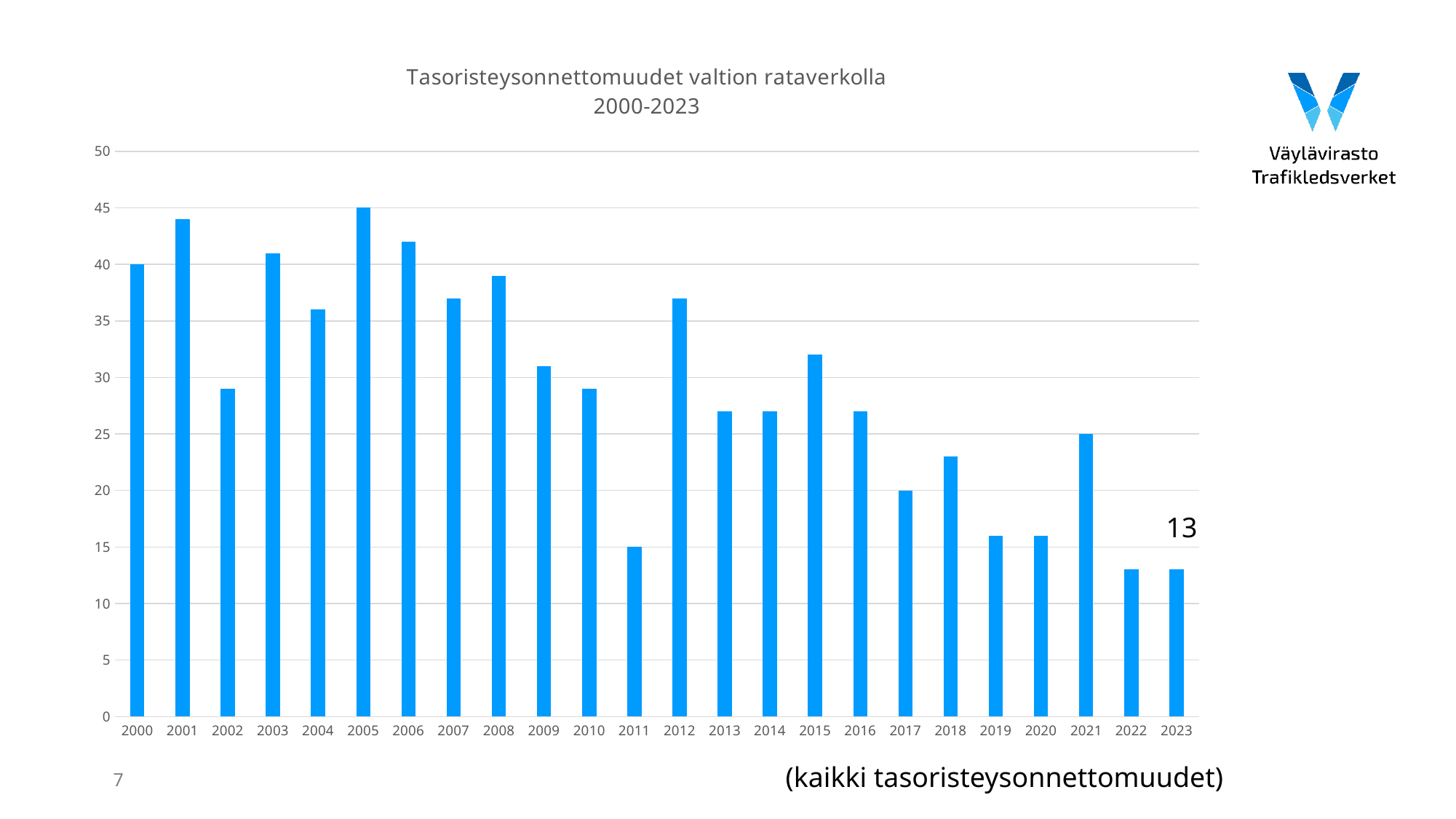
Which is larger, the value for 2000 or the value for 2010? 2000 What is the value for 2000? 40 How many years (bars) are shown on the chart? 24 Is the value for 2009 greater or less than 30? greater What is the value for 2017? 20 Is the value for 2018 greater or less than 25? less What is the value for 2023? 13 What is the difference between the values for 2005 and 2000? 5 What kind of chart is shown on the slide? bar chart Is the value for 2012 greater or less than 35? greater Do the values generally rise or fall from 2000 to 2023? fall What is the value for 2005? 45